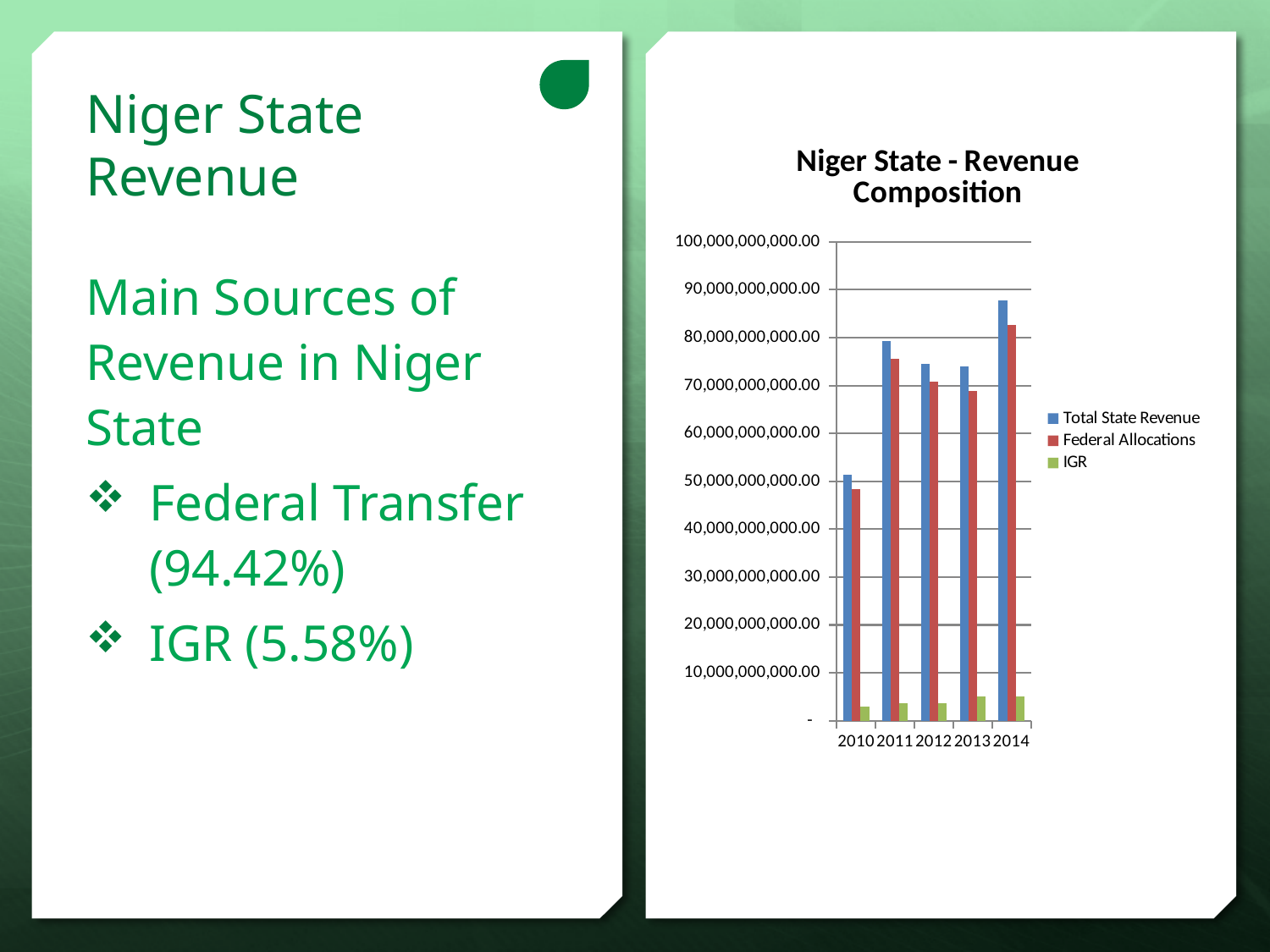
Which series is shown in green in the chart? IGR In which year is Total State Revenue lowest? 2010 In which year are Federal Allocations highest? 2014 Is the Total State Revenue for 2014 greater or less than 80,000,000,000.00? greater How many years are shown on the x axis of the chart? 5 How many series does the legend list? 3 Which is larger, Total State Revenue in 2011 or Total State Revenue in 2010? 2011 What kind of chart is shown on the slide? bar chart Is the IGR value for 2013 greater or less than 10,000,000,000.00? less Is the Federal Allocations value for 2010 greater or less than 50,000,000,000.00? less What is the title of the chart? Niger State - Revenue Composition In which year is Total State Revenue highest? 2014